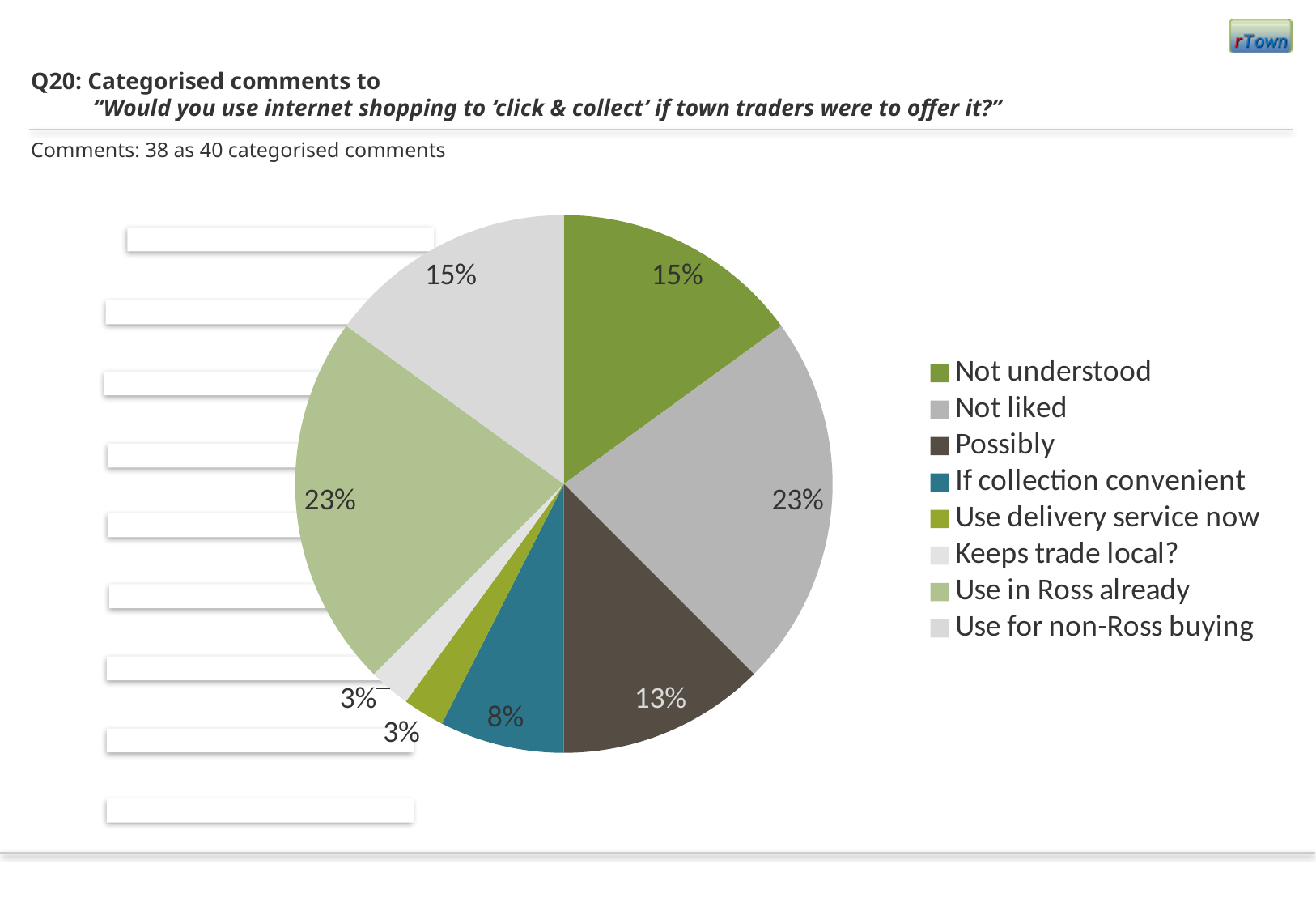
What kind of chart is shown on the slide? pie chart What share of comments is labelled for 'Use in Ross already'? 23% What is the difference in percentage points between the 'Not liked' share and the 'If collection convenient' share? 15 What share of comments is labelled for 'Use for non-Ross buying'? 15% What share of comments is labelled for 'Not understood'? 15% What share of comments is labelled for 'Not liked'? 23% What is the difference in percentage points between the 'Not understood' share and the 'Possibly' share? 2 What share of comments is labelled for 'Possibly'? 13% Which is larger, the share for 'Not liked' or the share for 'Possibly'? Not liked What share of comments is labelled for 'If collection convenient'? 8% Which is larger, the share for 'If collection convenient' or the share for 'Not understood'? Not understood How many categories does the legend list? 8